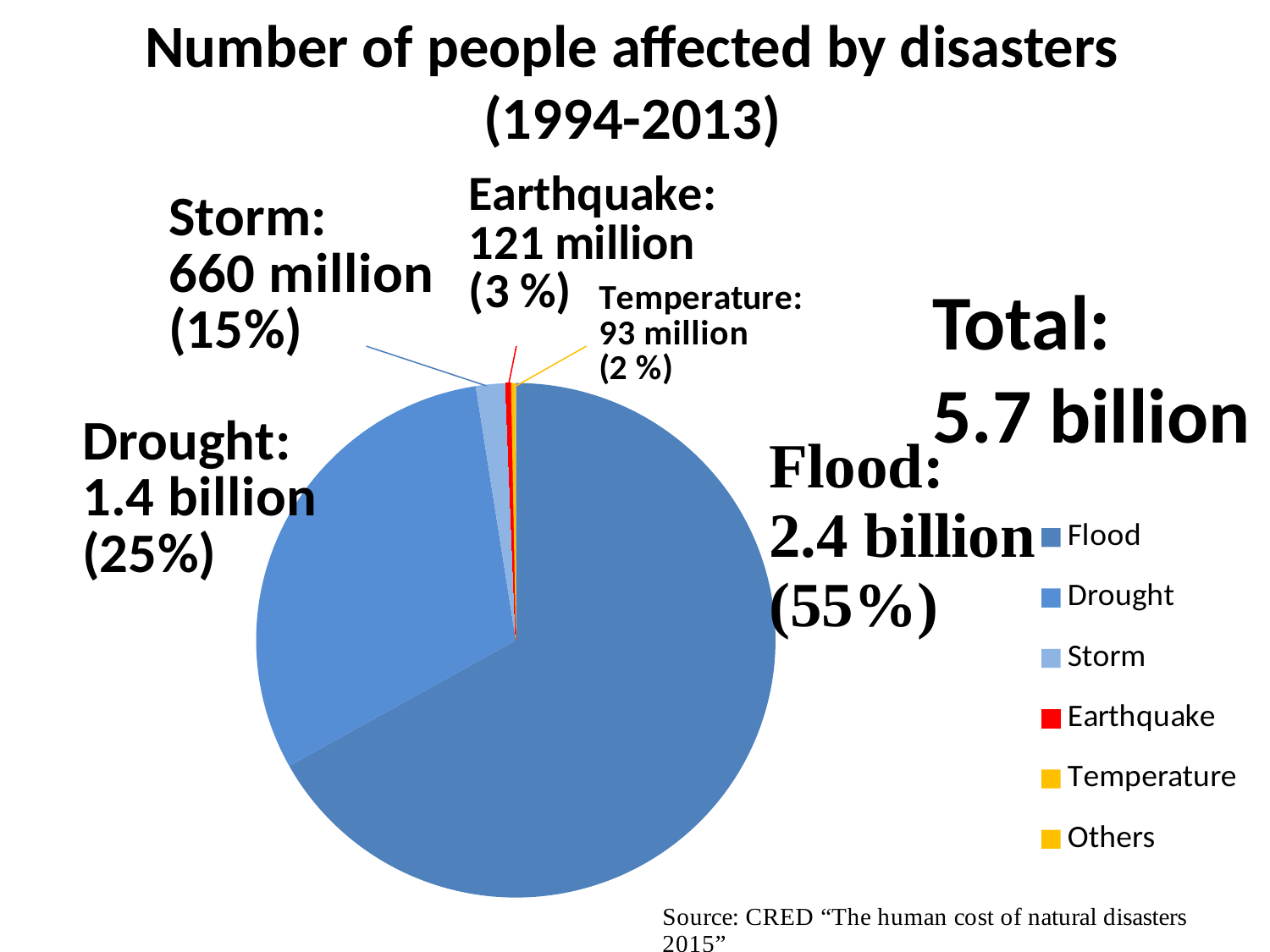
How many people were affected by earthquakes? 121 million Which category accounts for the largest share of people affected? Flood What kind of chart is shown on the slide? pie chart Which affected more people, Drought or Storm? Drought What is the title of the chart? Number of people affected by disasters (1994-2013) How many people were affected by storms? 660 million What is the total number of people affected by disasters shown on the slide? 5.7 billion How many people were affected by drought? 1.4 billion What share of the pie does Temperature represent? 2 % How many categories does the legend list? 6 What share of the pie does Flood represent? 55% How many people were affected by floods according to the chart? 2.4 billion